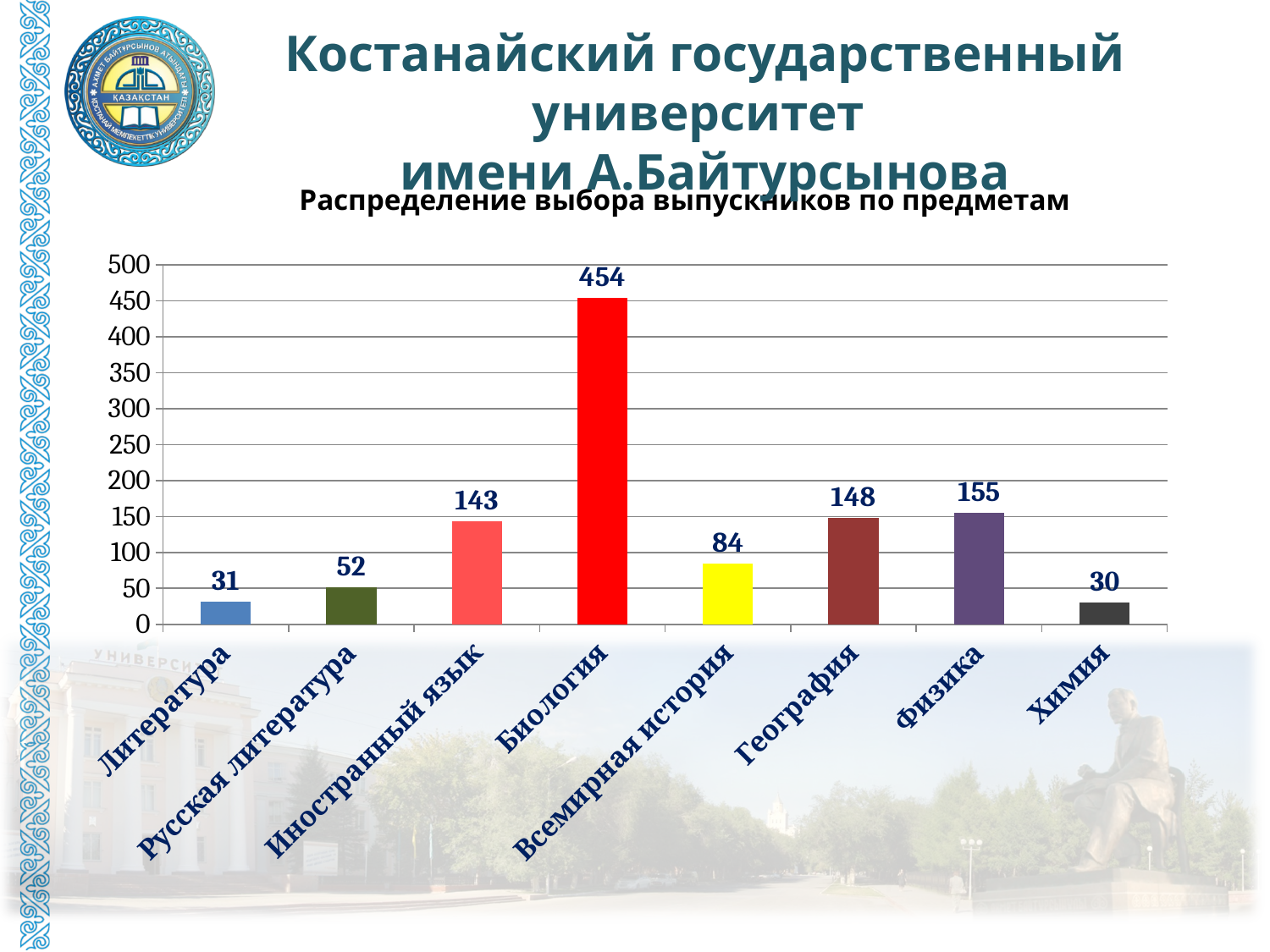
What is the value for Биология? 454 What is the difference between the values for Биология and Иностранный язык? 311 Which subject has the lowest value? Химия What is the title of the chart? Распределение выбора выпускников по предметам Which is larger, the value for Русская литература or the value for Литература? Русская литература Which subject has the highest value? Биология What kind of chart is shown on the slide? bar chart How many subjects are shown on the x axis? 8 What is the value for Всемирная история? 84 What is the difference between the values for Физика and География? 7 What is the value for Иностранный язык? 143 Is the value for География greater or less than 100? greater